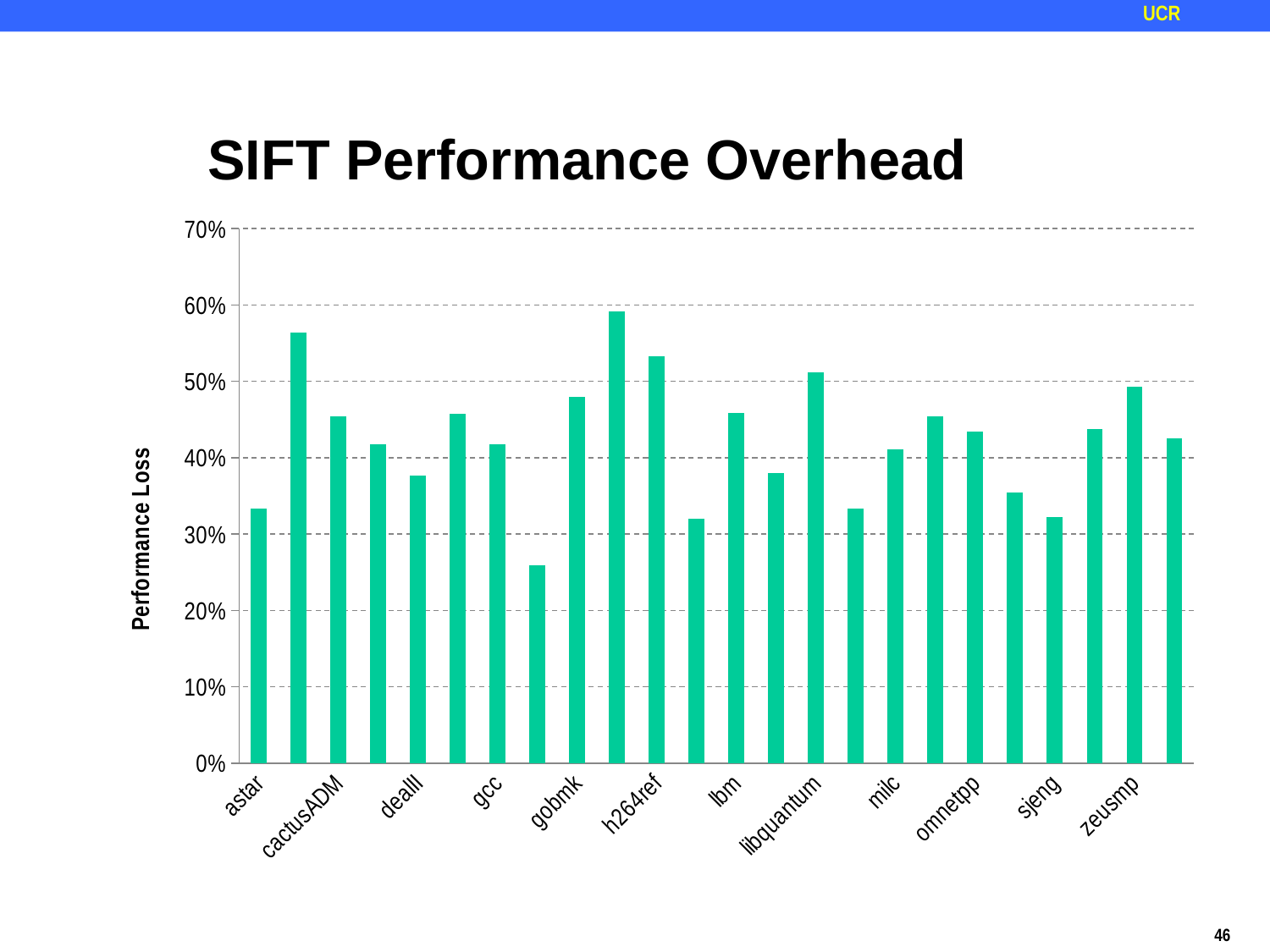
Which has the larger performance loss, gobmk or dealII? gobmk How many category labels are shown along the x axis? 12 Is the value for h264ref greater or less than 50%? greater Is the value for gobmk greater or less than 50%? less How many bars are plotted in the chart? 24 What is the label on the vertical axis of the chart? Performance Loss What kind of chart is shown on the slide? bar chart Which has the larger performance loss, h264ref or astar? h264ref What is the title of the chart? SIFT Performance Overhead Is the value for lbm greater or less than 40%? greater